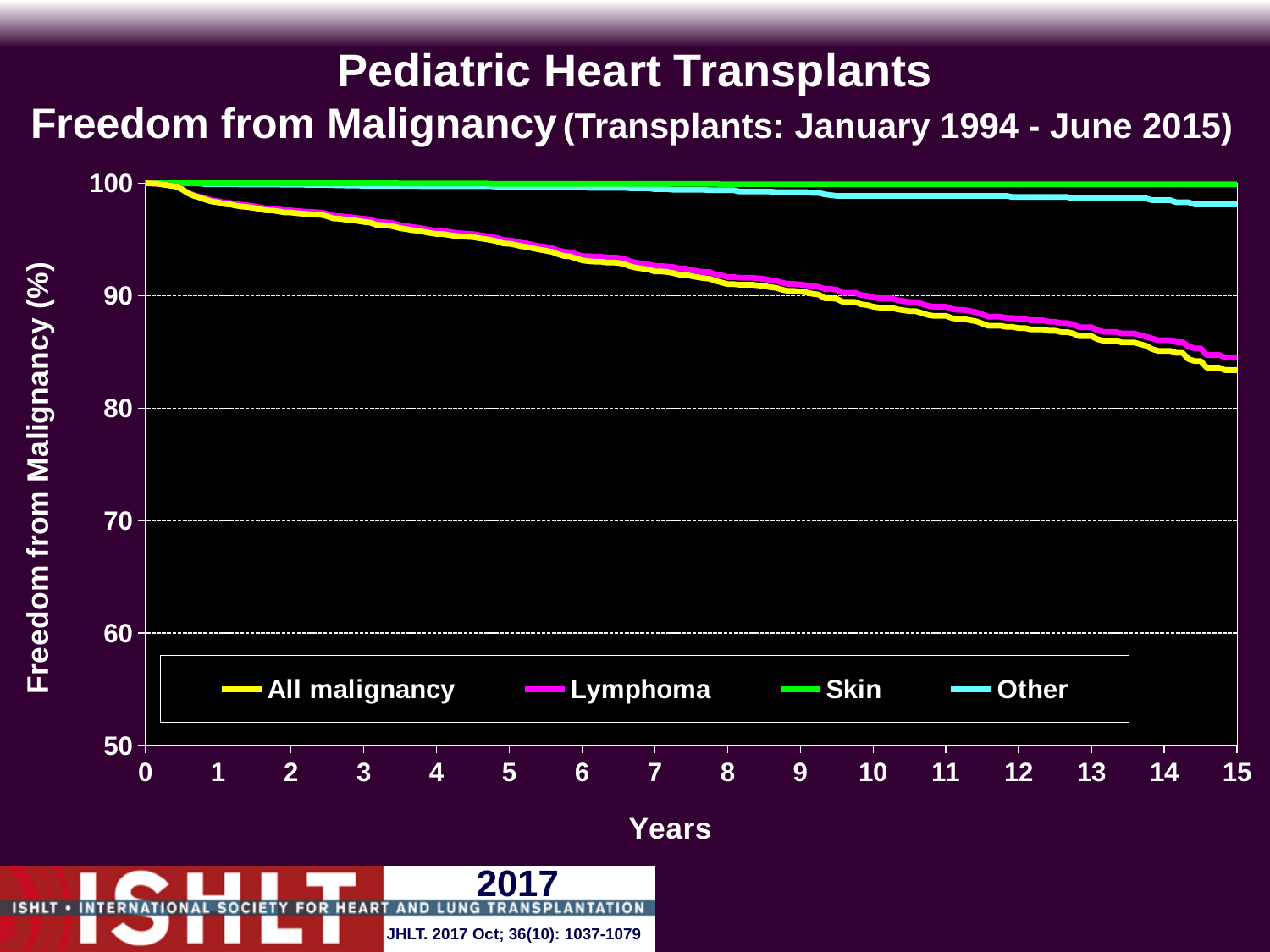
Is the value for All malignancy at 5 years greater or less than 90? greater Is the value for All malignancy at 15 years greater or less than 80? greater Is the value for Lymphoma at 15 years greater or less than 80? greater What is the label of the y axis? Freedom from Malignancy (%) Which series has the highest freedom from malignancy at 15 years? Skin Which series are listed in the legend? All malignancy, Lymphoma, Skin, Other How many series does the legend list? 4 At 15 years, which is higher: Skin or All malignancy? Skin Does the All malignancy line rise or fall as years increase? fall What kind of chart is shown on the slide? line chart